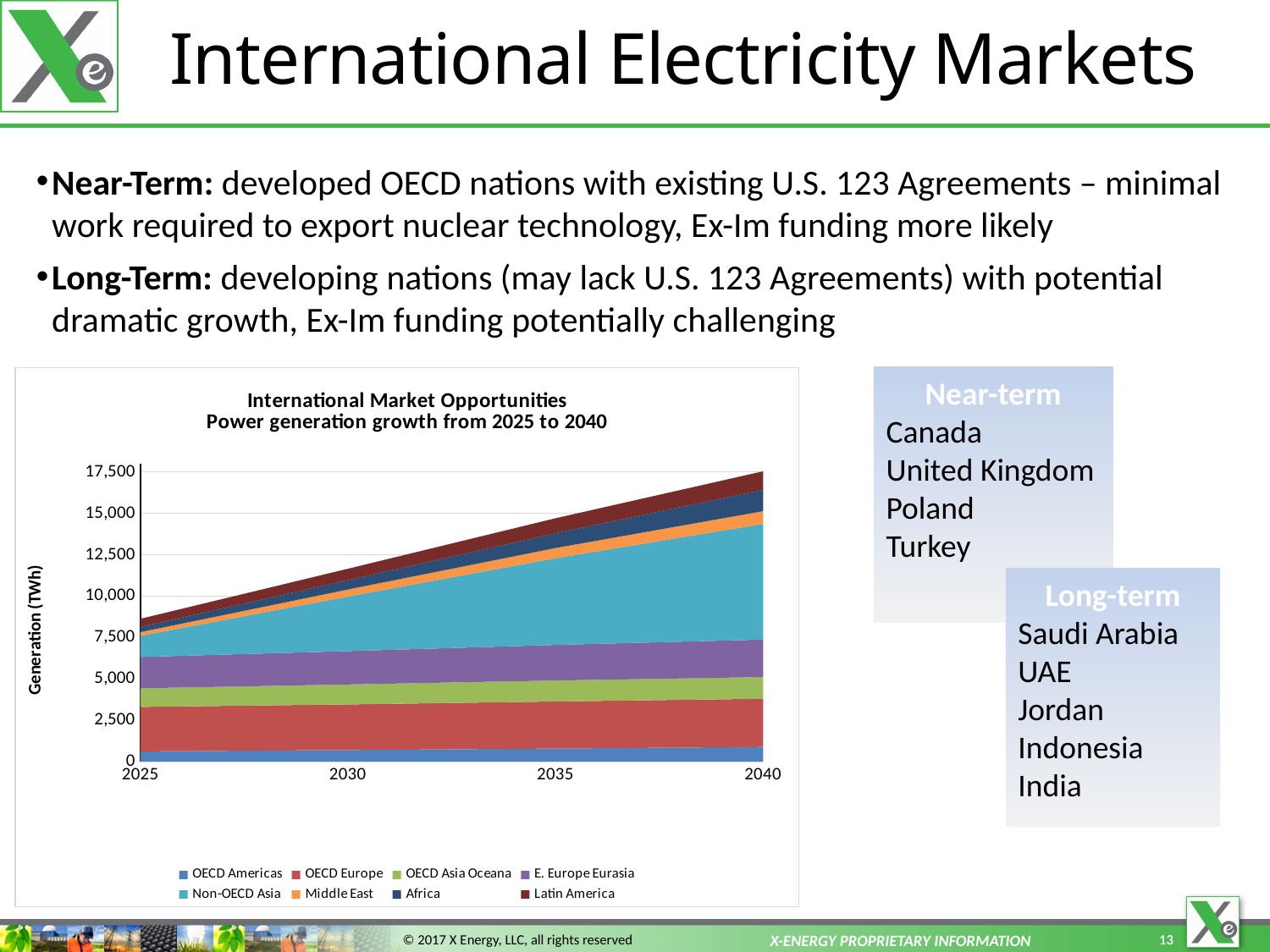
Is the total stacked generation in 2040 greater or less than 15,000 TWh? greater Which region shows the greatest growth in generation between 2025 and 2040? Non-OECD Asia What kind of chart is shown on the slide? Stacked area chart What is the label on the chart's y axis? Generation (TWh) Which region's band is larger in 2040, Non-OECD Asia or OECD Europe? Non-OECD Asia How many series does the chart's legend list? 8 What is the title of the chart? International Market Opportunities Power generation growth from 2025 to 2040 Which region has the largest generation band in 2040? Non-OECD Asia Does total power generation rise or fall from 2025 to 2040 in the chart? Rises How many years are labelled on the x axis of the chart? 4 Is the total stacked generation in 2025 greater or less than 10,000 TWh? less